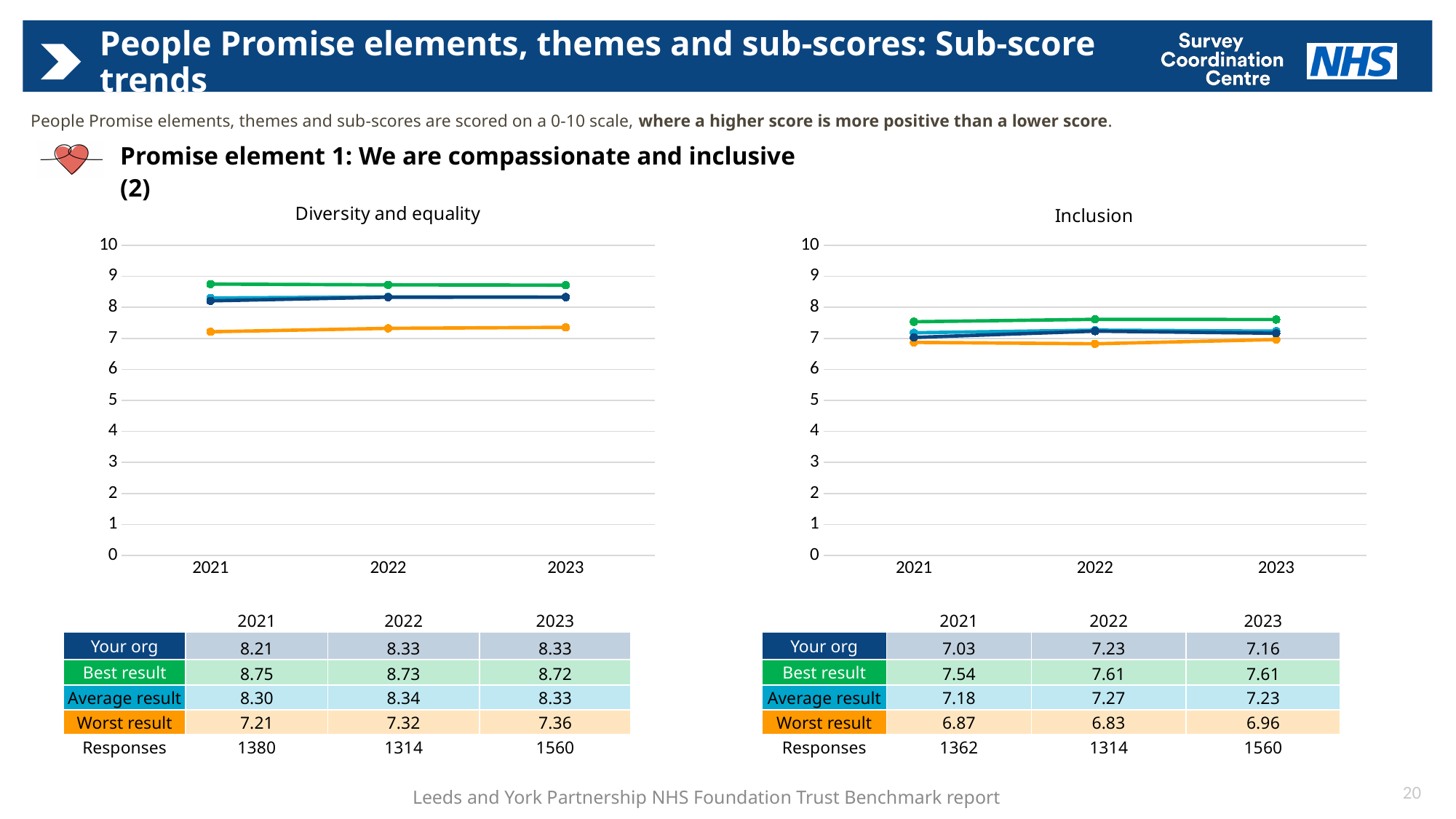
In the 'Diversity and equality' chart, which year has the highest 'Best result' score? 2021 In the 'Diversity and equality' chart, does the 'Worst result' line rise or fall from 2021 to 2023? rise What kind of chart is the 'Diversity and equality' chart? line chart In the 'Inclusion' chart, what is the 'Best result' score for 2022? 7.61 In the 'Diversity and equality' chart, what is the 'Your org' score for 2023? 8.33 In the 'Diversity and equality' chart, what is the difference between the 'Best result' and 'Worst result' scores in 2021? 1.54 In the 'Inclusion' chart, what is the difference between the 'Your org' scores for 2022 and 2023? 0.07 How many years are plotted on the x axis of the 'Inclusion' chart? 3 In the 'Inclusion' chart, what is the 'Worst result' score for 2021? 6.87 In the 'Diversity and equality' chart, is the 'Worst result' value for 2022 greater or less than 8? less In the 'Inclusion' chart, which year has the lowest 'Worst result' score? 2022 In the 'Inclusion' chart, which is larger: the 'Your org' score in 2021 or the 'Average result' score in 2021? Average result